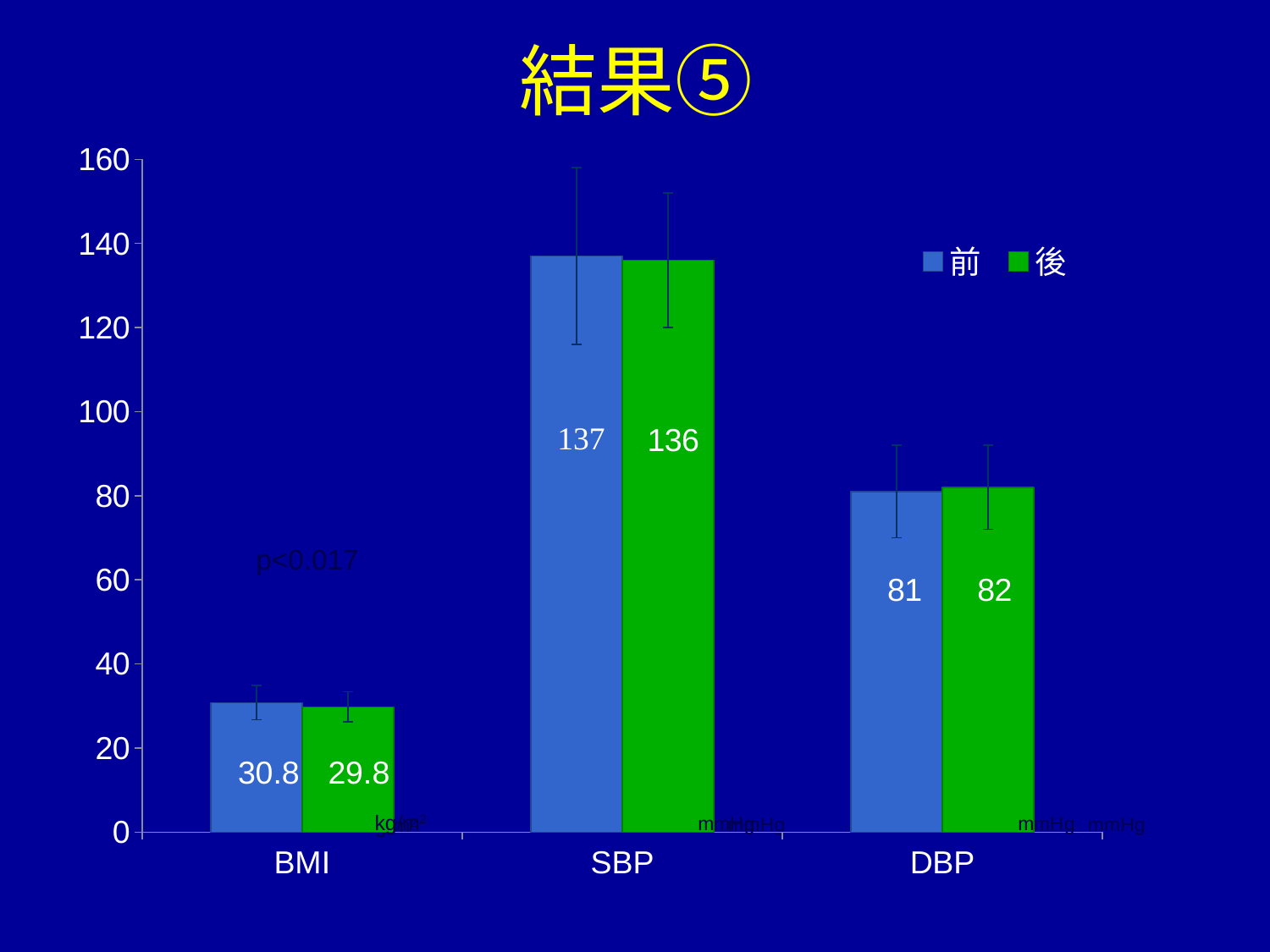
What is the value of 後 for BMI? 29.8 How many series does the legend list? 2 Which category has the highest value for 前? SBP What is the value of 前 for DBP? 81 What is the value of 前 for BMI? 30.8 How many categories are shown on the x axis? 3 What is the value of 後 for SBP? 136 What is the value of 前 for SBP? 137 What is the difference between the 前 and 後 values for BMI? 1.0 What is the value of 後 for DBP? 82 What kind of chart is shown on the slide? bar chart Which category has the lowest value for 後? BMI